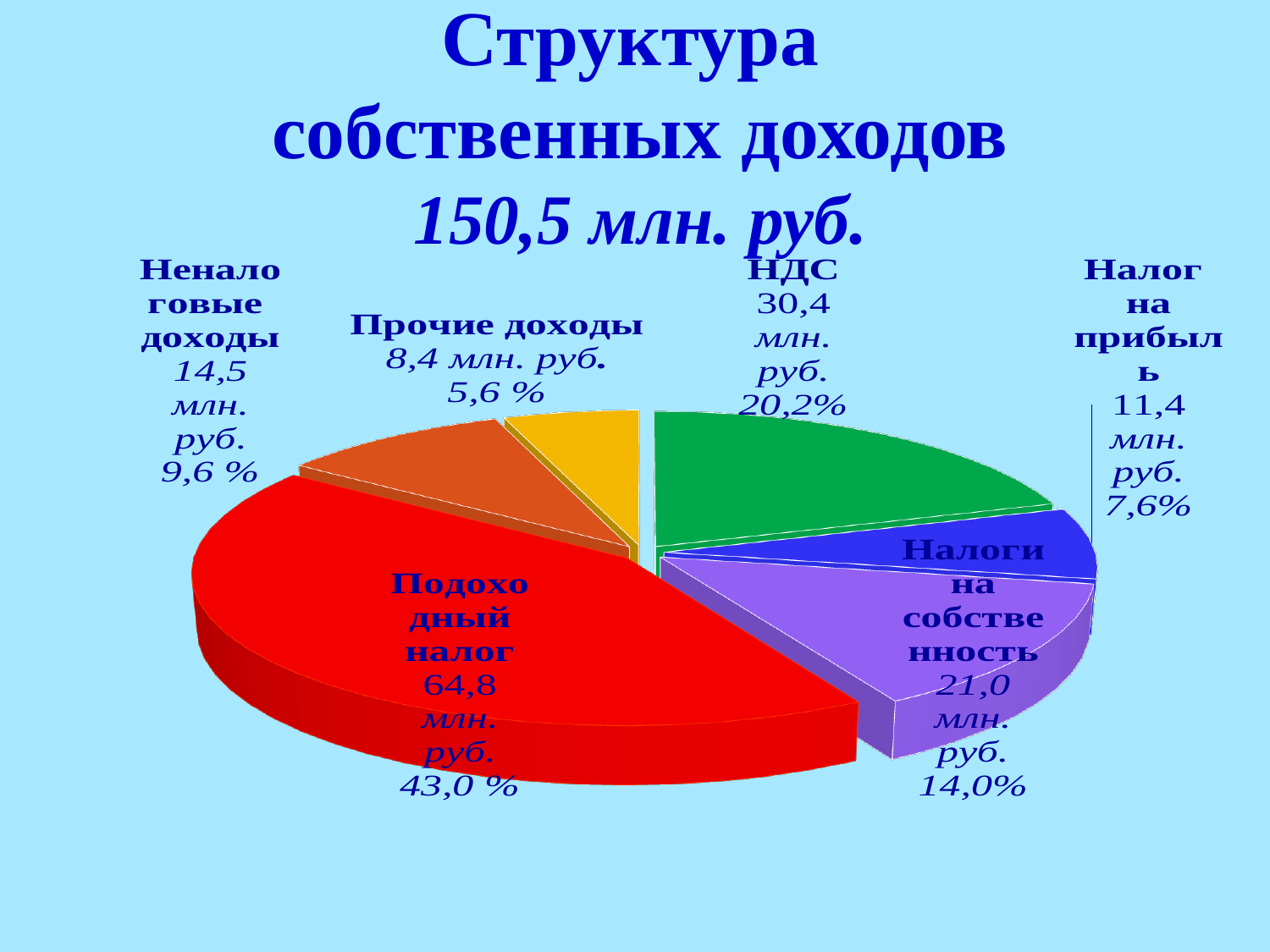
How many slices does the pie chart have? 6 What percentage is shown for Неналоговые доходы? 9,6 % Which category has the smallest slice of the pie? Прочие доходы What share of the pie does НДС represent? 20,2% What is the value for Налоги на собственность? 21,0 млн. руб. What kind of chart is shown on the slide? pie chart What total amount is stated in the chart title? 150,5 млн. руб. Which category has the largest slice of the pie? Подоходный налог What is the value for Подоходный налог? 64,8 млн. руб. Which is larger, Налоги на собственность or Неналоговые доходы? Налоги на собственность What is the difference in млн. руб. between НДС and Налог на прибыль? 19,0 млн. руб. What colour is the slice for Подоходный налог? red